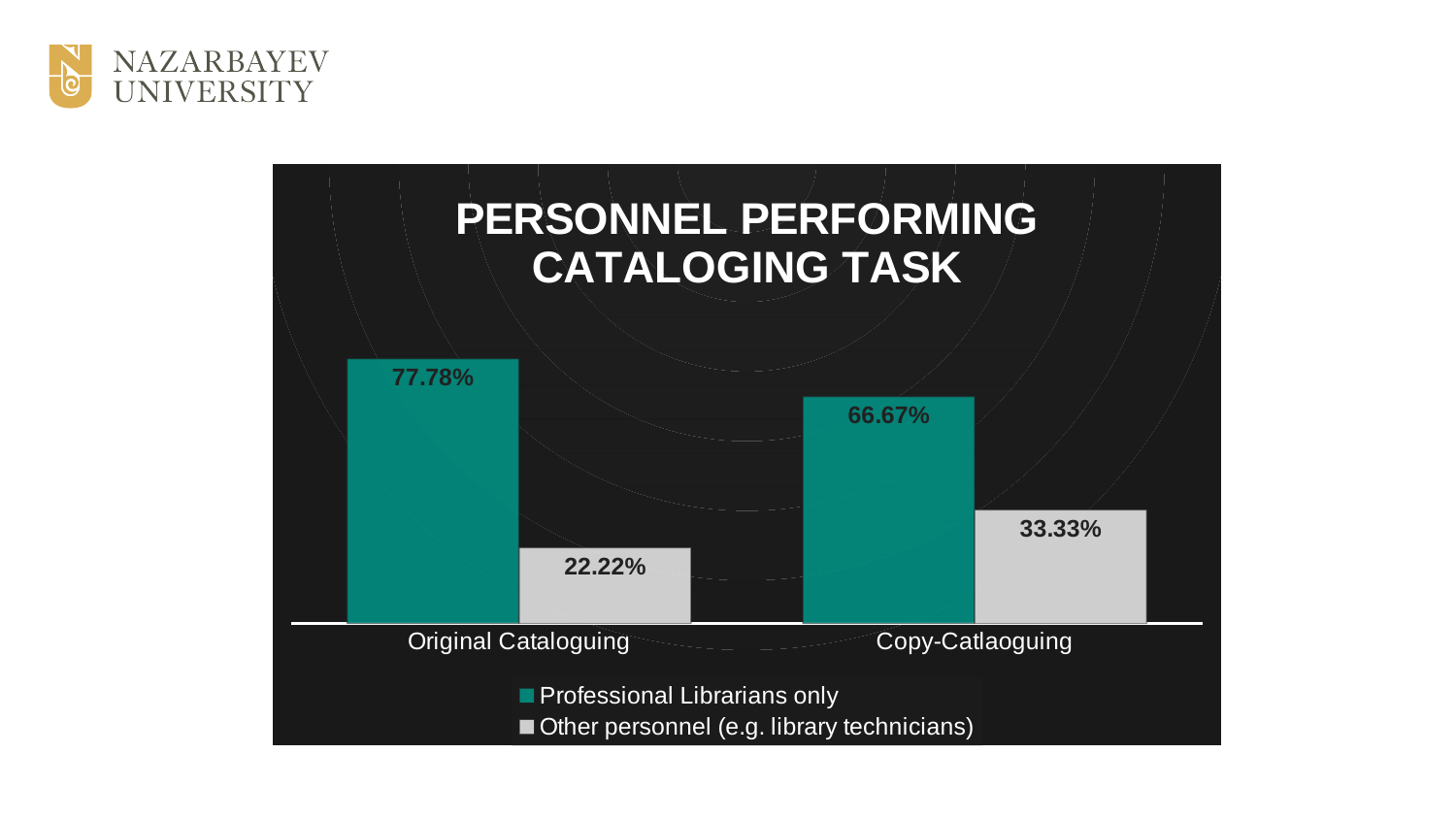
Which category has the highest value for Professional Librarians only? Original Cataloguing Which is larger: Other personnel in Copy-Catlaoguing or Other personnel in Original Cataloguing? Other personnel in Copy-Catlaoguing What kind of chart is shown on the slide? Bar chart Which category has the lowest value for Other personnel (e.g. library technicians)? Original Cataloguing How many series does the legend list? 2 What is the value for Professional Librarians only in Original Cataloguing? 77.78% How many categories are shown on the x axis? 2 What is the difference between Professional Librarians only and Other personnel in Copy-Catlaoguing? 33.34% What is the value for Other personnel (e.g. library technicians) in Original Cataloguing? 22.22% What is the value for Other personnel (e.g. library technicians) in Copy-Catlaoguing? 33.33% What is the difference between Professional Librarians only and Other personnel in Original Cataloguing? 55.56% What is the value for Professional Librarians only in Copy-Catlaoguing? 66.67%